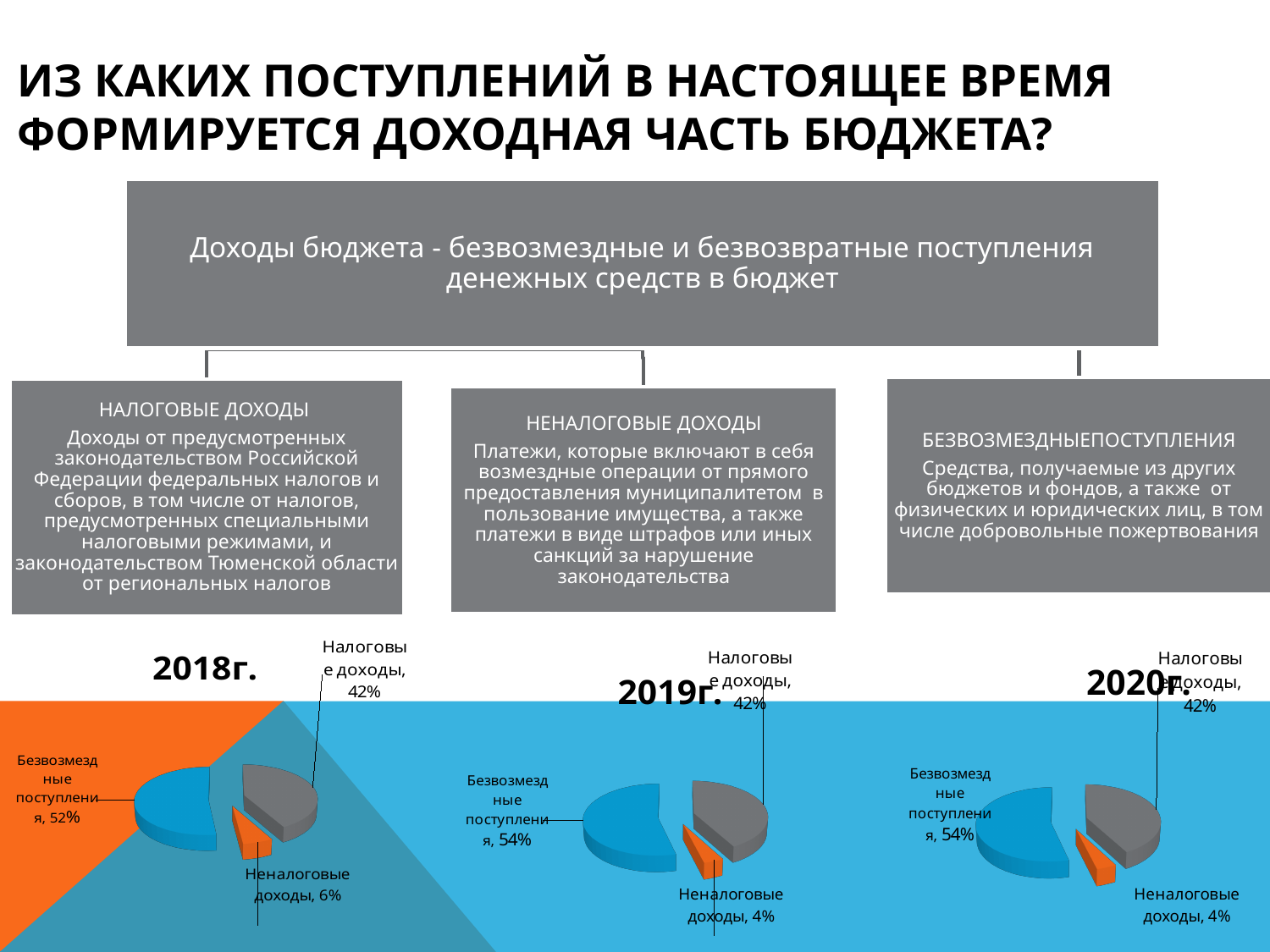
Сколько категорий показано на диаграмме «2020г.»? 3 На диаграмме «2018г.» какая доля приходится на безвозмездные поступления? 52% На диаграмме «2018г.» какая доля приходится на неналоговые доходы? 6% На диаграмме «2018г.» что больше: доля налоговых доходов или доля безвозмездных поступлений? Безвозмездные поступления На диаграмме «2020г.» какая доля приходится на безвозмездные поступления? 54% На диаграмме «2019г.» какая категория имеет наибольшую долю? Безвозмездные поступления Сколько круговых диаграмм показано на слайде? 3 На диаграмме «2020г.» какая категория имеет наименьшую долю? Неналоговые доходы На диаграмме «2018г.» на сколько процентных пунктов доля безвозмездных поступлений больше доли налоговых доходов? 10 На диаграмме «2019г.» какая доля приходится на налоговые доходы? 42% Какого типа диаграмма «2019г.»? Круговая диаграмма На диаграмме «2019г.» на сколько процентных пунктов доля налоговых доходов больше доли неналоговых доходов? 38